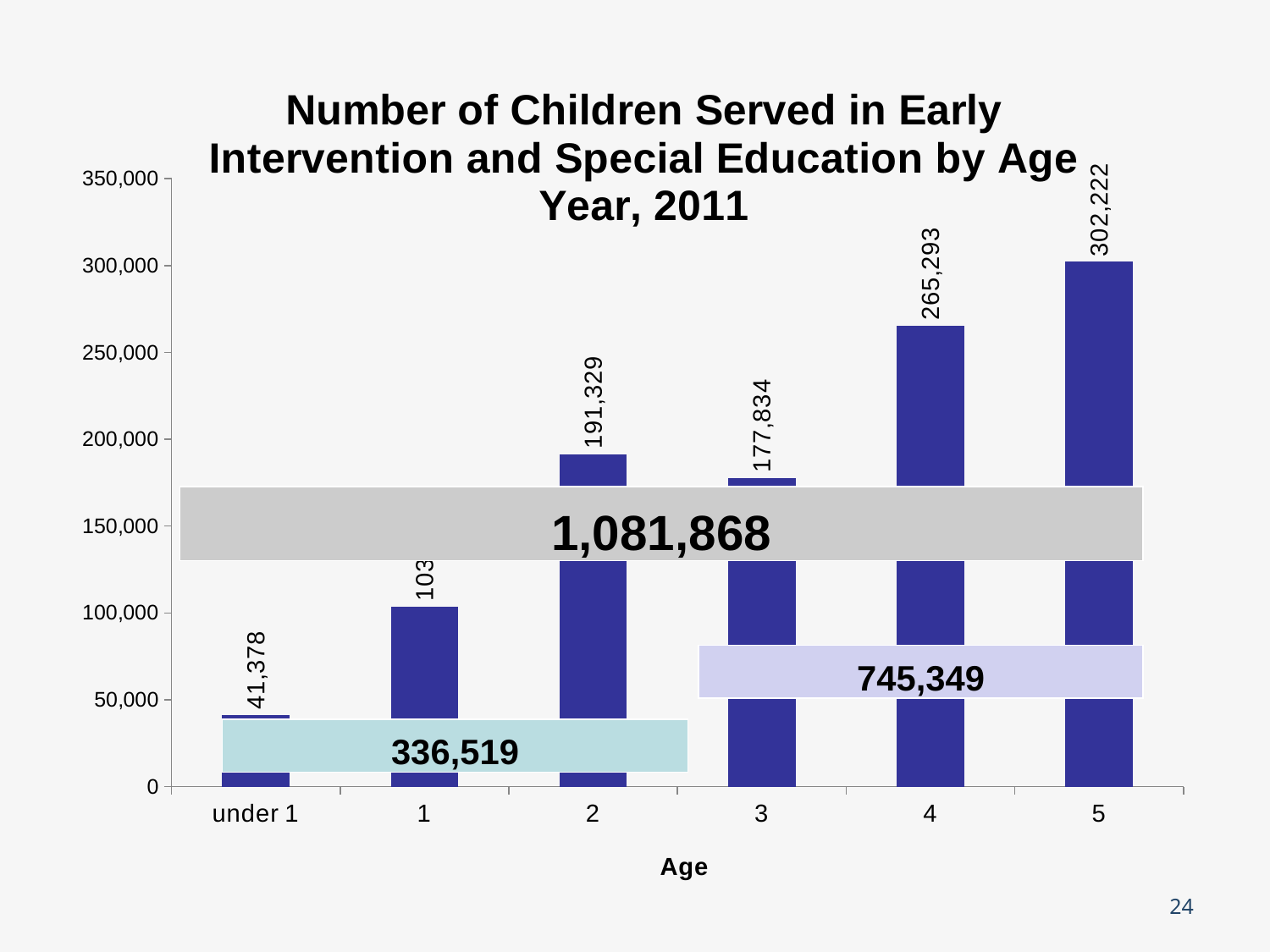
What is the difference between the number served at age 5 and at age 4? 36,929 How many age categories are plotted on the x axis? 6 Which age has the highest number of children served? 5 How many children under 1 were served? 41,378 Which age has the lowest number of children served? under 1 What is the number of children served at age 4? 265,293 What is the number of children served at age 3? 177,834 Which is larger, the number served at age 2 or at age 3? age 2 What total is shown in the large grey band across the chart? 1,081,868 Do the values rise or fall from age 3 to age 5? rise What kind of chart is shown on the slide? bar chart Is the value for age 1 greater or less than 150,000? less